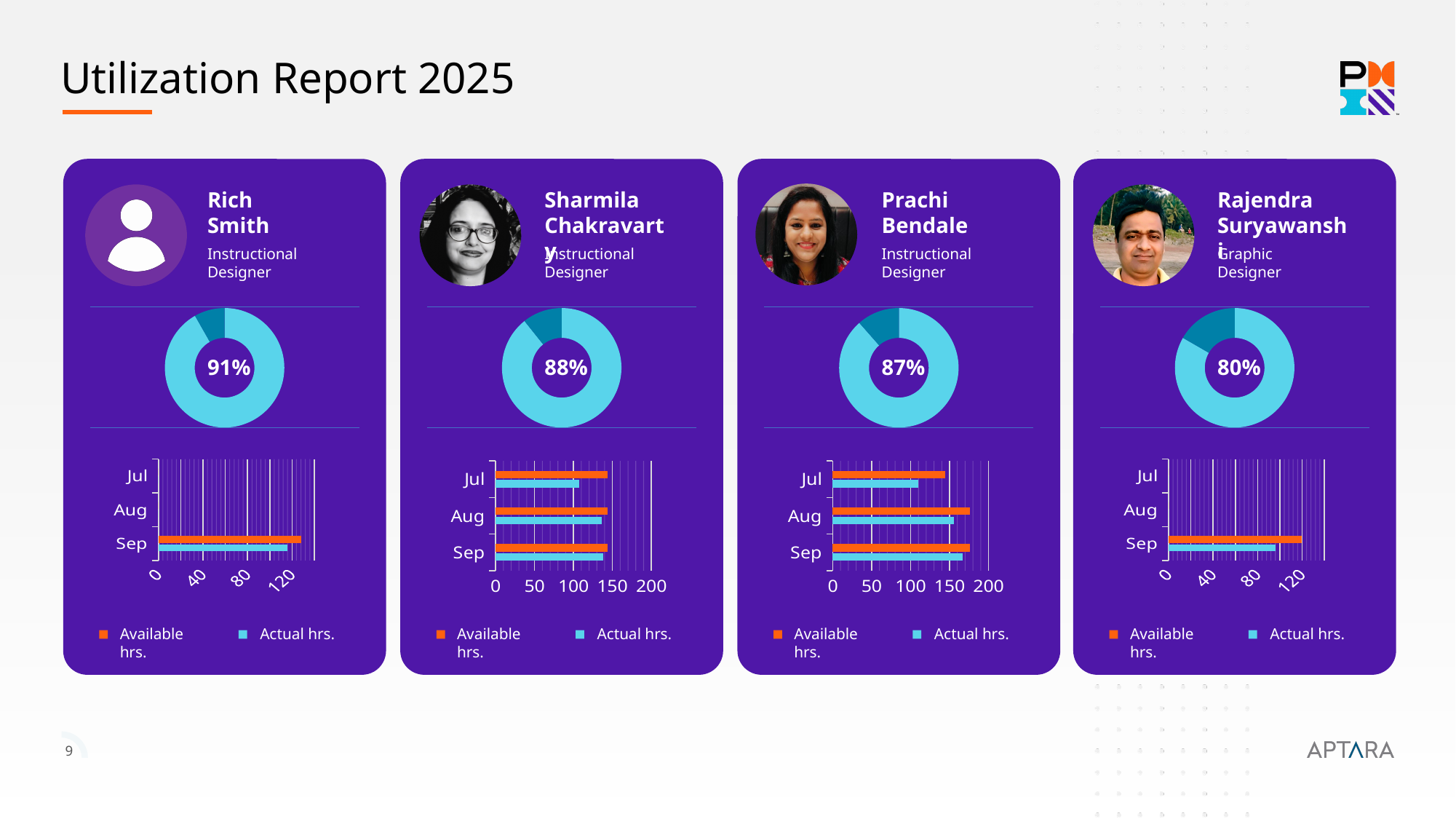
What is the difference between Rich Smith's and Rajendra Suryawanshi's donut chart percentages? 11 percentage points What kind of chart is shown at the bottom of each card, below the donut chart? Bar chart Across the four donut charts, which person has the highest utilization percentage? Rich Smith On the Rajendra Suryawanshi card, what utilization percentage is shown in the donut chart? 80% On the Prachi Bendale bar chart, is the Available hrs. value for Aug greater or less than 150? greater How many series does the legend of the bar chart on the Prachi Bendale card list? 2 How many months are listed on the y axis of the bar chart on the Sharmila Chakravarty card? 3 On the Rich Smith card, what utilization percentage is shown in the donut chart? 91% Comparing the donut charts, who has the higher percentage: Sharmila Chakravarty or Prachi Bendale? Sharmila Chakravarty What are the two legend entries shown under the bar chart on the Rich Smith card? Available hrs. and Actual hrs. Across the four donut charts, which person has the lowest utilization percentage? Rajendra Suryawanshi